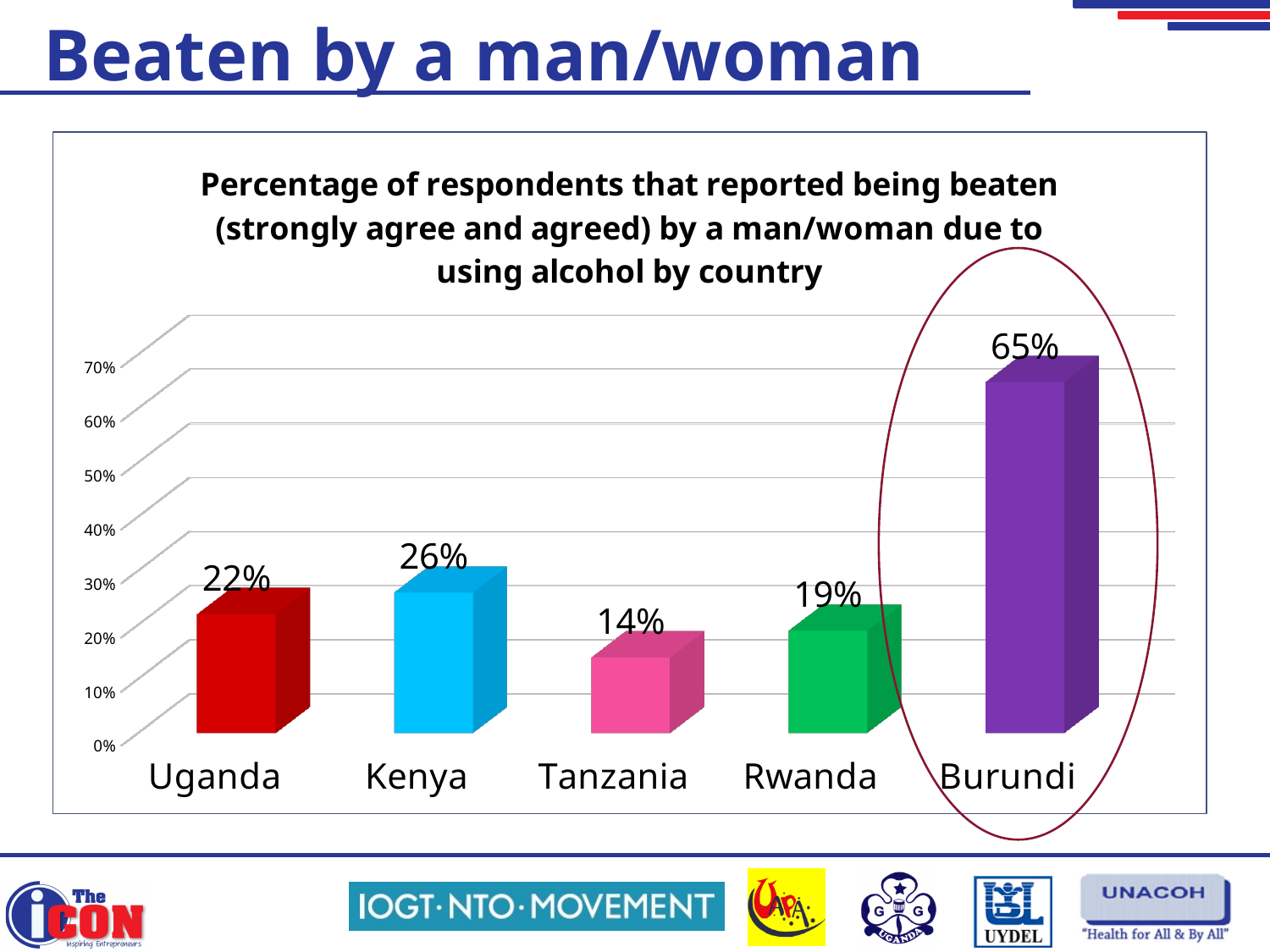
What is the difference between the values for Burundi and Kenya? 39% What is the value shown for Rwanda? 19% What is the value shown for Tanzania? 14% Which country has the highest percentage of respondents reporting being beaten? Burundi What kind of chart is shown on the slide? Bar chart How many countries are shown in the chart? 5 What percentage of respondents in Uganda reported being beaten by a man/woman due to using alcohol? 22% Is the value for Burundi greater or less than 60%? greater What is the value shown for Kenya? 26% Which country's bar is circled on the chart? Burundi Which country has the lowest percentage of respondents reporting being beaten? Tanzania Which has a higher value, Uganda or Rwanda? Uganda